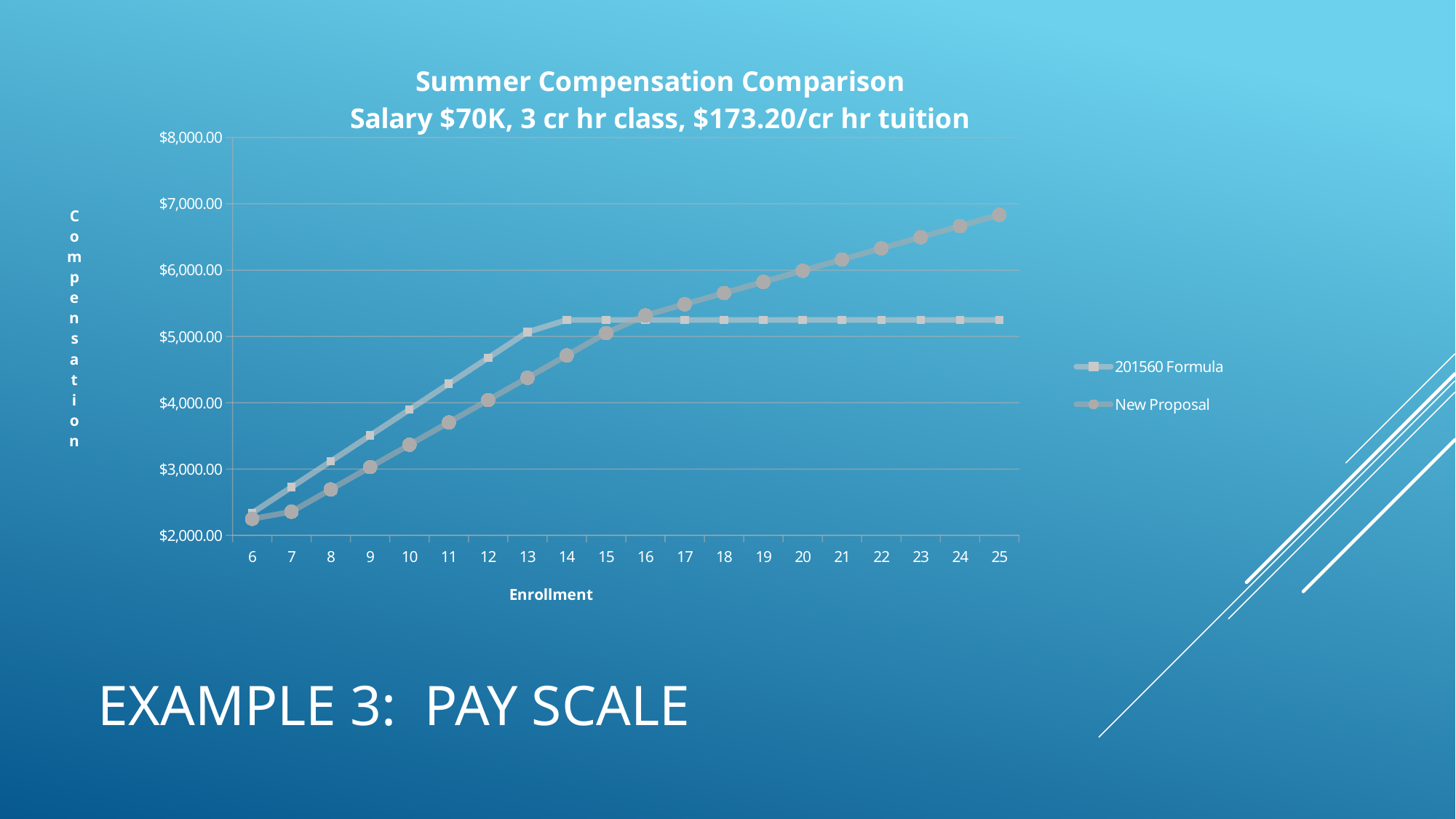
Is the New Proposal value at enrollment 6 greater or less than $3,000.00? less Does the New Proposal line rise or fall as enrollment increases from 6 to 25? Rises Is the 201560 Formula value at enrollment 9 greater or less than $3,000.00? greater Is the New Proposal value at enrollment 25 greater or less than $6,000.00? greater At enrollment 25, which series has the higher compensation, 201560 Formula or New Proposal? New Proposal How many enrollment values are plotted along the x axis? 20 At enrollment 10, which series has the higher compensation, 201560 Formula or New Proposal? 201560 Formula What kind of chart is shown on the slide? Line chart Does the 201560 Formula line rise, fall, or stay flat between enrollment 14 and enrollment 25? Stays flat What is the title of the x axis? Enrollment How many series does the legend list? 2